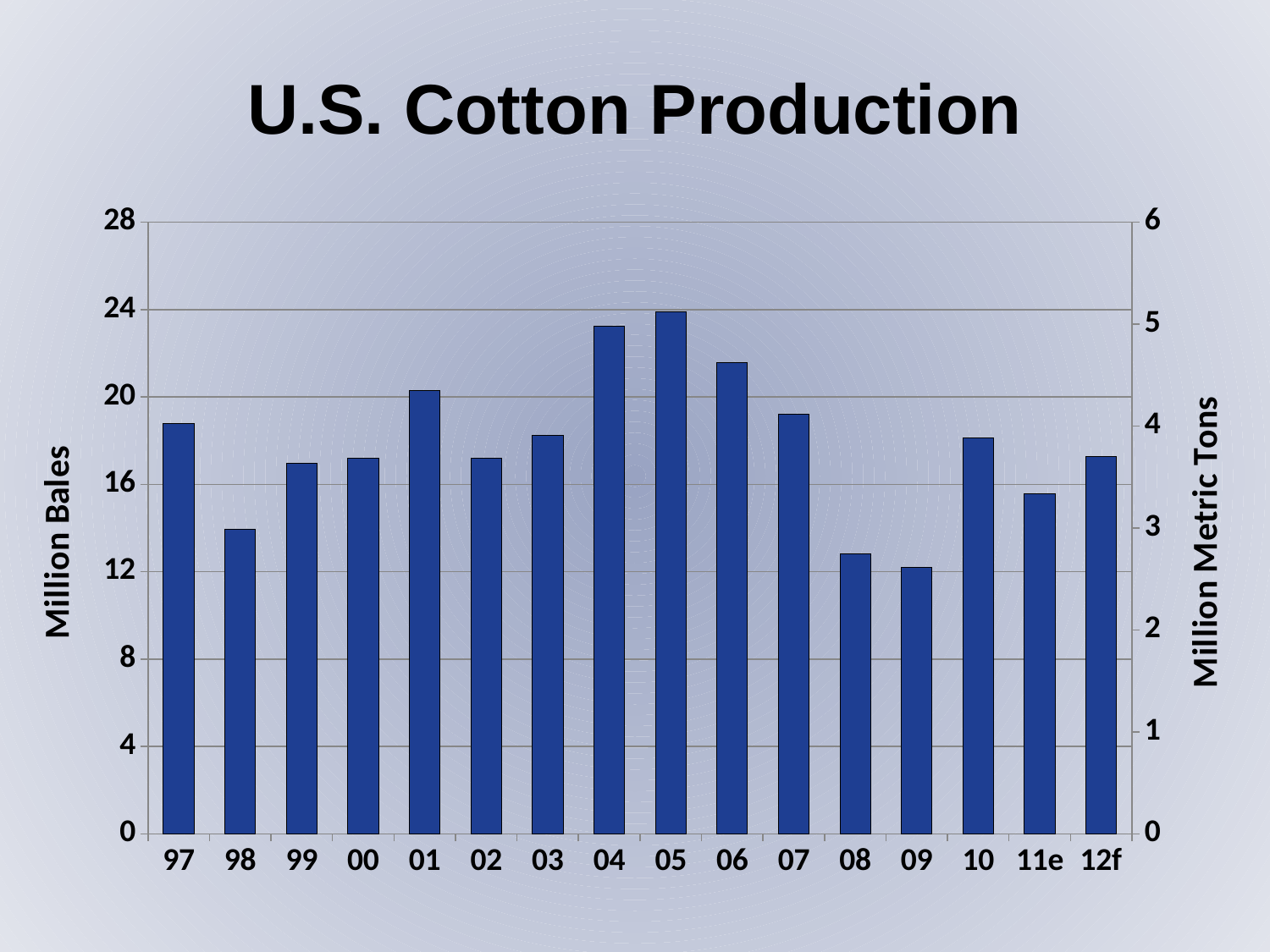
What is the title of the chart? U.S. Cotton Production What type of chart is shown on the slide? bar chart Is the value for 98 greater or less than 16 million bales? less Do the values rise or fall from 05 to 09? fall Is the value for 05 greater or less than 20 million bales? greater How many years (bars) are shown on the x axis? 16 Is the value for 97 greater or less than 16 million bales? greater Which year has the larger production, 03 or 04? 04 What is the label of the left vertical axis? Million Bales Which year has the lowest cotton production? 09 Which year has the highest cotton production? 05